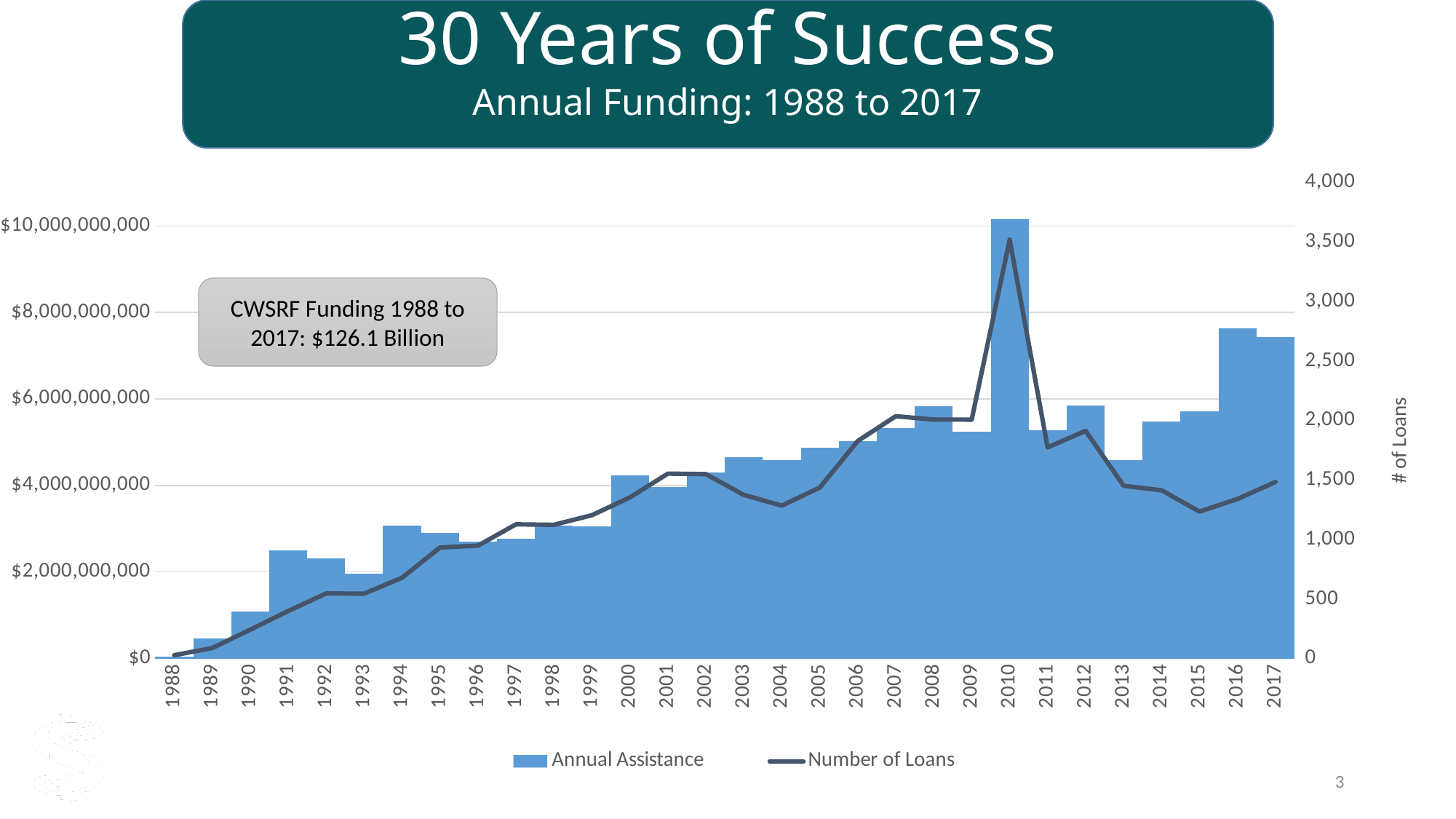
What kind of chart is shown on the slide? Combination bar and line chart Is the Number of Loans for 2015 greater or less than 1,500? less Which year has the larger Annual Assistance, 2012 or 2016? 2016 In which year is Annual Assistance highest? 2010 How many series does the chart legend list? 2 Is the Annual Assistance value for 2010 greater or less than $8,000,000,000? greater How many years are shown along the x axis of the chart? 30 Is the Annual Assistance value for 1988 greater or less than $2,000,000,000? less In which year does the Number of Loans line reach its peak? 2010 In which year is Annual Assistance lowest? 1988 Does the Number of Loans line rise or fall from 1988 to 1997? rise